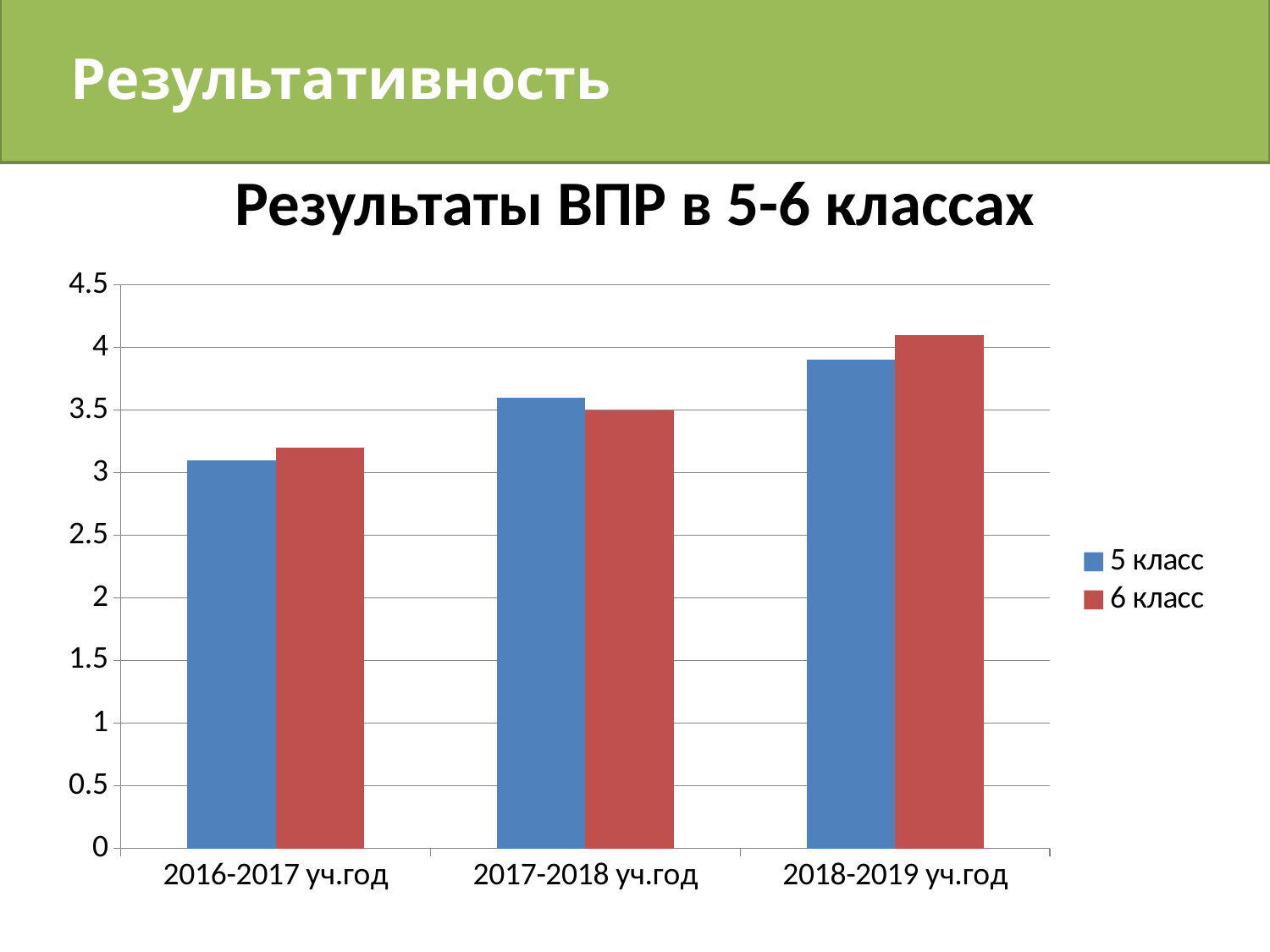
In which academic year is the value for 5 класс highest? 2018-2019 уч.год Is the value for 6 класс in 2018-2019 уч.год greater or less than 4? greater How many academic years are shown on the x axis? 3 Is the value for 5 класс in 2018-2019 уч.год greater or less than 4? less In 2017-2018 уч.год, which series has the larger value, 5 класс or 6 класс? 5 класс In 2018-2019 уч.год, which series has the larger value, 5 класс or 6 класс? 6 класс In which academic year is the value for 6 класс lowest? 2016-2017 уч.год What kind of chart is shown on the slide? bar chart What is the title of the chart? Результаты ВПР в 5-6 классах How many series does the legend list? 2 Which colour represents the 6 класс series? red Do the values for 5 класс rise or fall from 2016-2017 уч.год to 2018-2019 уч.год? rise